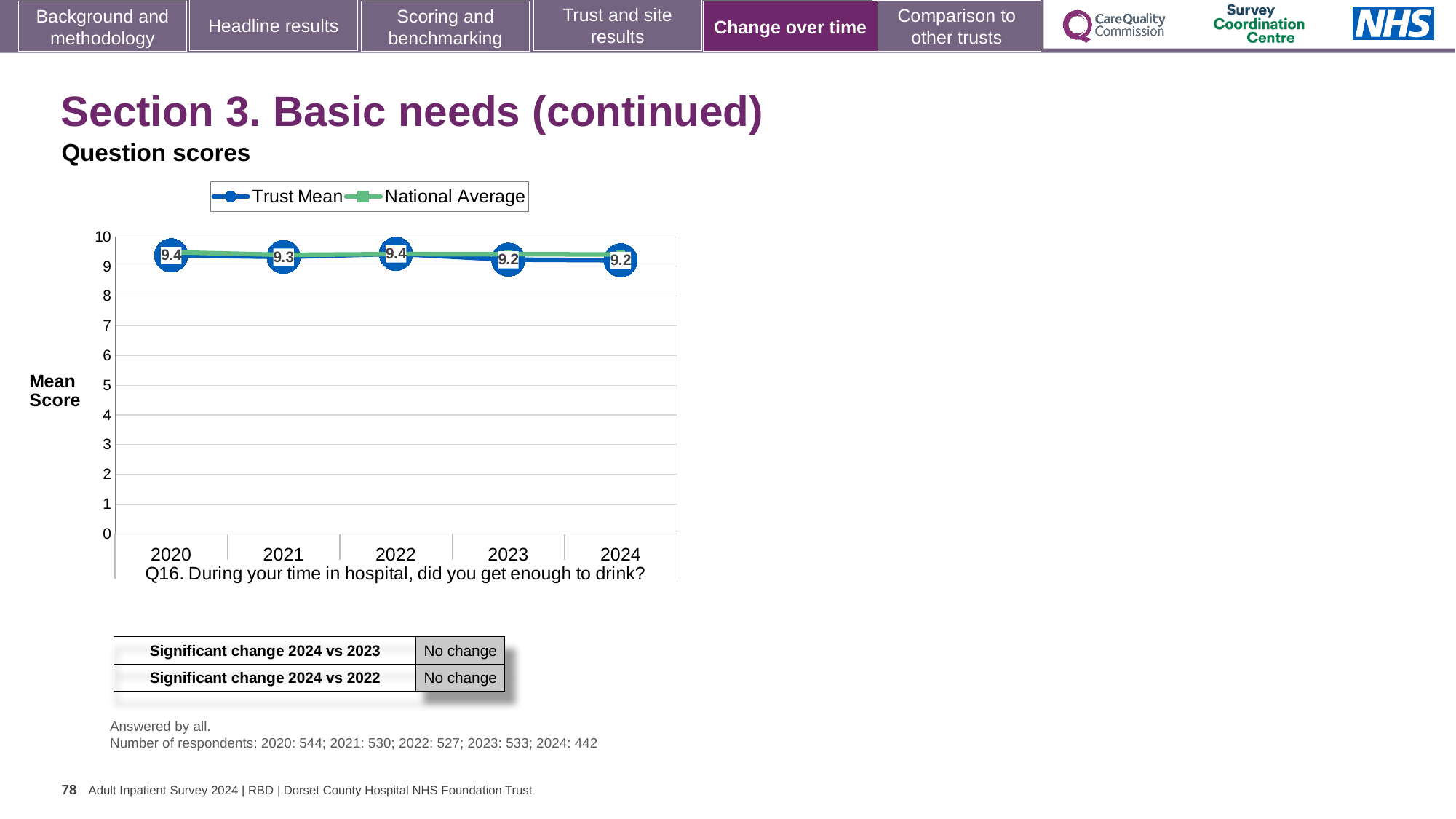
Which year has the larger Trust Mean score, 2020 or 2023? 2020 Is the National Average value for 2020 greater or less than 9? greater Which survey question does the chart show scores for? Q16. During your time in hospital, did you get enough to drink? What is the Trust Mean score for 2021? 9.3 What is the difference between the Trust Mean score in 2022 and in 2024? 0.2 Does the Trust Mean score rise or fall from 2020 to 2024? Fall What is the Trust Mean score for 2020? 9.4 What is the Trust Mean score for 2023? 9.2 How many years are plotted on the x axis of the chart? 5 What is the Trust Mean score for 2024? 9.2 How many series does the chart legend list? 2 What kind of chart is shown on the slide? Line chart